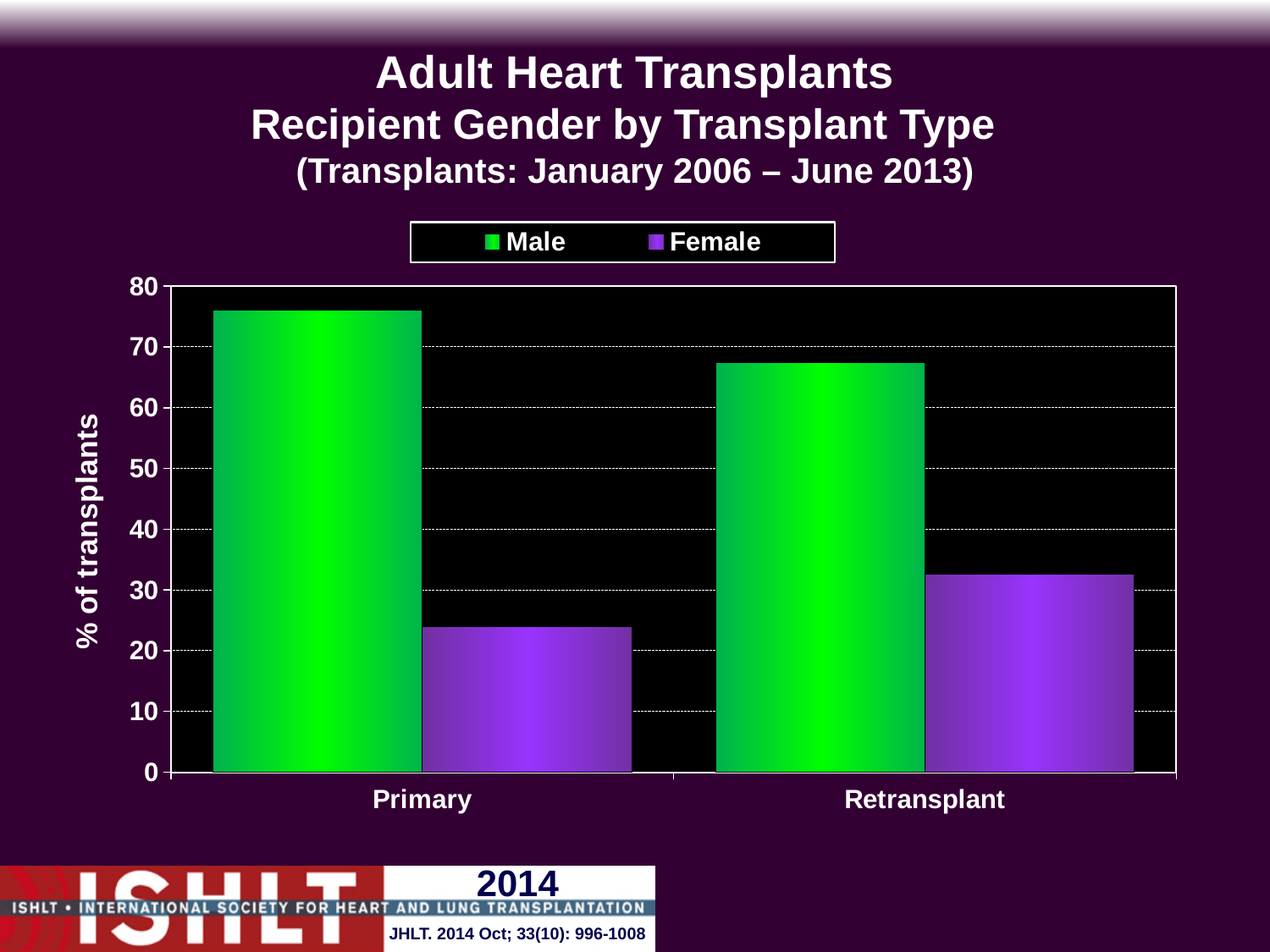
Which series has the higher value for Retransplant, Male or Female? Male Which bar is the lowest on the chart? Female, Primary What is the label of the y axis? % of transplants How many series does the legend list? 2 What kind of chart is shown on the slide? bar chart How many transplant type categories are shown on the x axis? 2 Is the value for Female in the Retransplant category greater or less than 40? less Which bar is the highest on the chart? Male, Primary Is the value for Male in the Primary category greater or less than 70? greater Which series has the higher value for Primary transplants, Male or Female? Male Is the value for Male in the Retransplant category greater or less than 60? greater